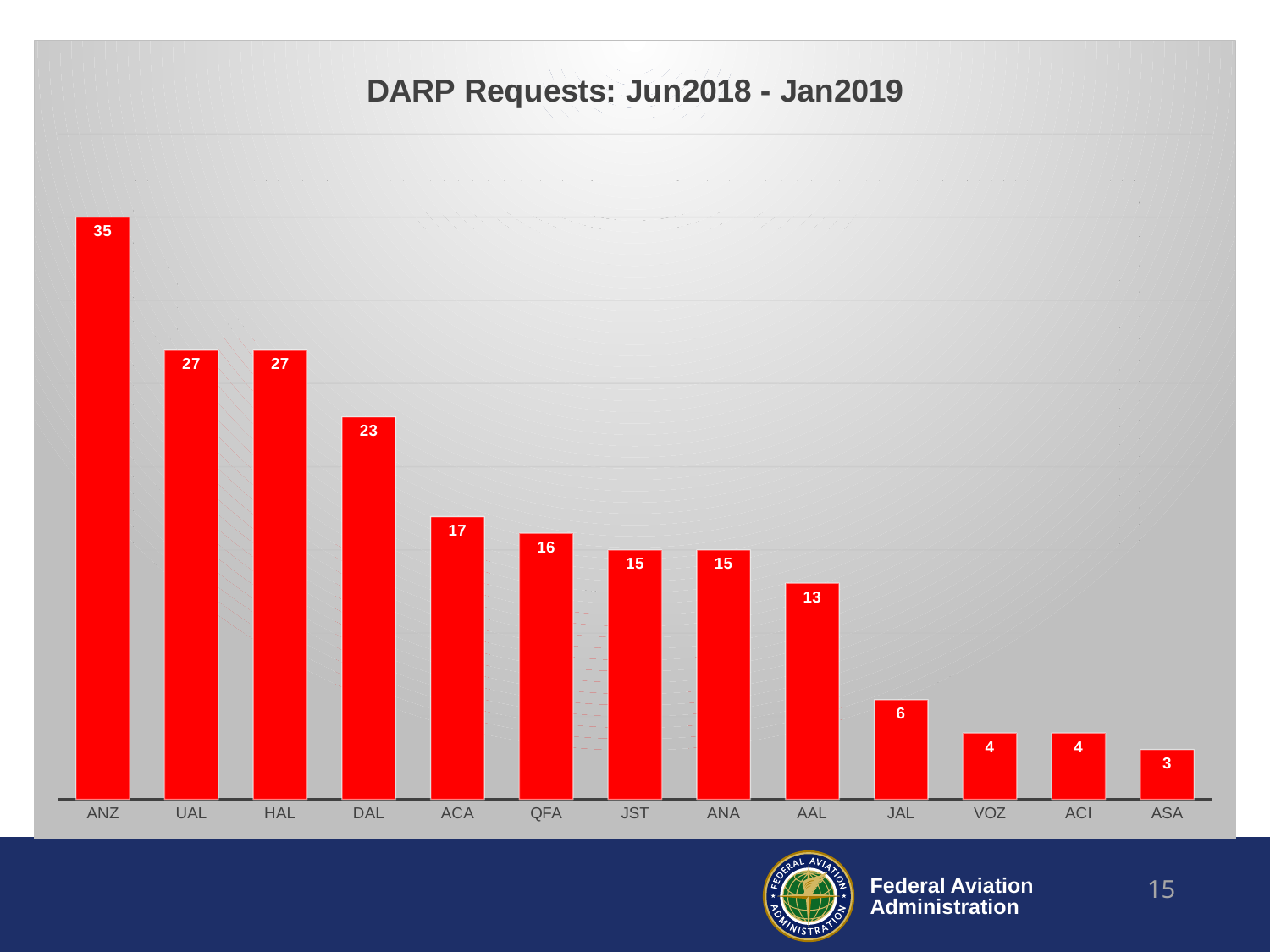
What is the value for JAL? 6 Which category has the lowest value? ASA What is the difference between the values for ACA and AAL? 4 Which category has the highest value? ANZ What is the difference between the values for ANZ and UAL? 8 Which is larger, the value for QFA or the value for JST? QFA What is the value for DAL? 23 What is the value for ANZ? 35 Do the values rise or fall from left to right along the x axis? Fall What kind of chart is this? Bar chart How many categories are shown on the x axis? 13 What is the title of the chart? DARP Requests: Jun2018 - Jan2019